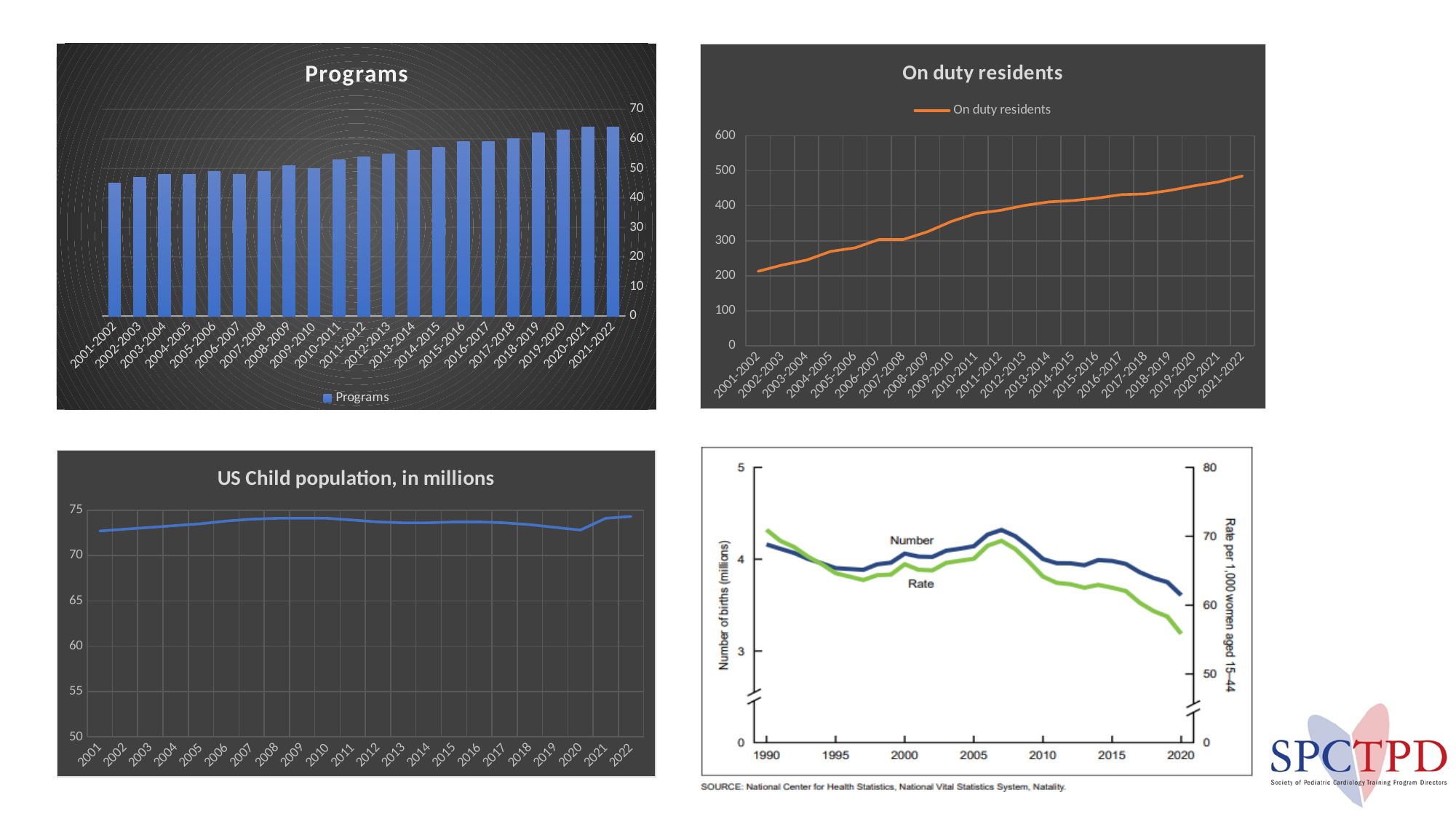
In the "On duty residents" chart, is the value for 2021-2022 greater or less than 400? greater In the "On duty residents" chart, is the value for 2001-2002 greater or less than 300? less In the "Programs" chart, how many academic years are shown on the x axis? 21 In the births chart at the bottom right, does the "Rate" line rise or fall overall from 1990 to 2020? fall What kind of chart is the "US Child population, in millions" chart at the bottom left? line chart In the "US Child population, in millions" chart, is the value for 2022 greater or less than 70? greater What kind of chart is the "Programs" chart at the top left? bar chart In the "On duty residents" chart, do the values generally rise or fall from 2001-2002 to 2021-2022? rise How many series does the legend of the "On duty residents" chart list? 1 In the "Programs" chart, which academic year has the lowest number of programs? 2001-2002